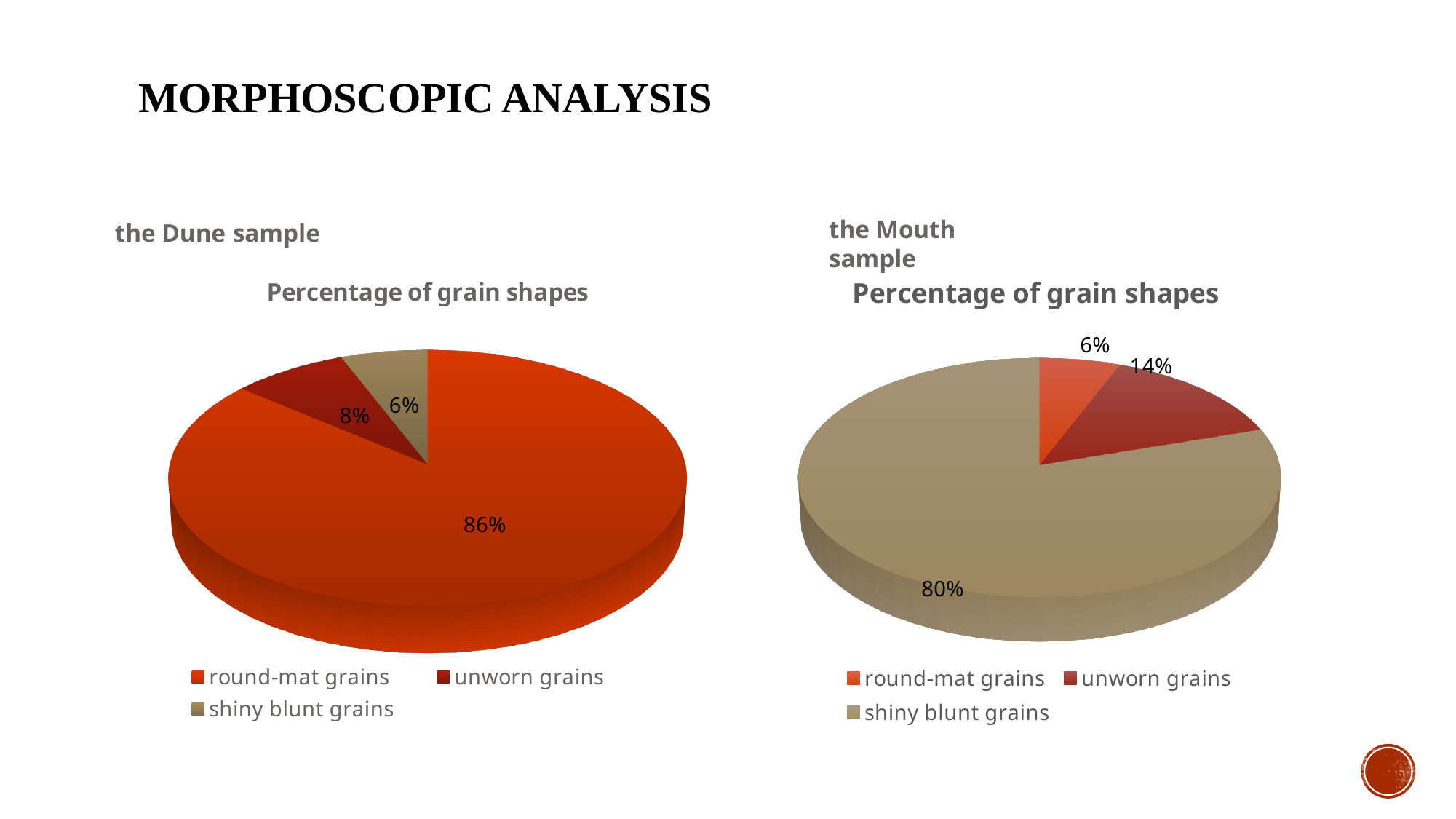
In the Mouth sample pie chart, what percentage is unworn grains? 14% How many categories does the Dune sample pie chart show? 3 What is the title of the Dune sample chart? Percentage of grain shapes In the Dune sample pie chart, which grain shape has the smallest share? shiny blunt grains In the Dune sample pie chart, what percentage is round-mat grains? 86% In the Mouth sample pie chart, which grain shape has the smallest share? round-mat grains In the Dune sample pie chart, what is the difference between the round-mat grains share and the unworn grains share? 78% Which is larger: the unworn grains share in the Dune sample or the unworn grains share in the Mouth sample? the Mouth sample In the Mouth sample pie chart, which grain shape has the largest share? shiny blunt grains What type of chart is used for the Mouth sample? pie chart In the Dune sample pie chart, what percentage is unworn grains? 8% In the Mouth sample pie chart, what percentage is shiny blunt grains? 80%